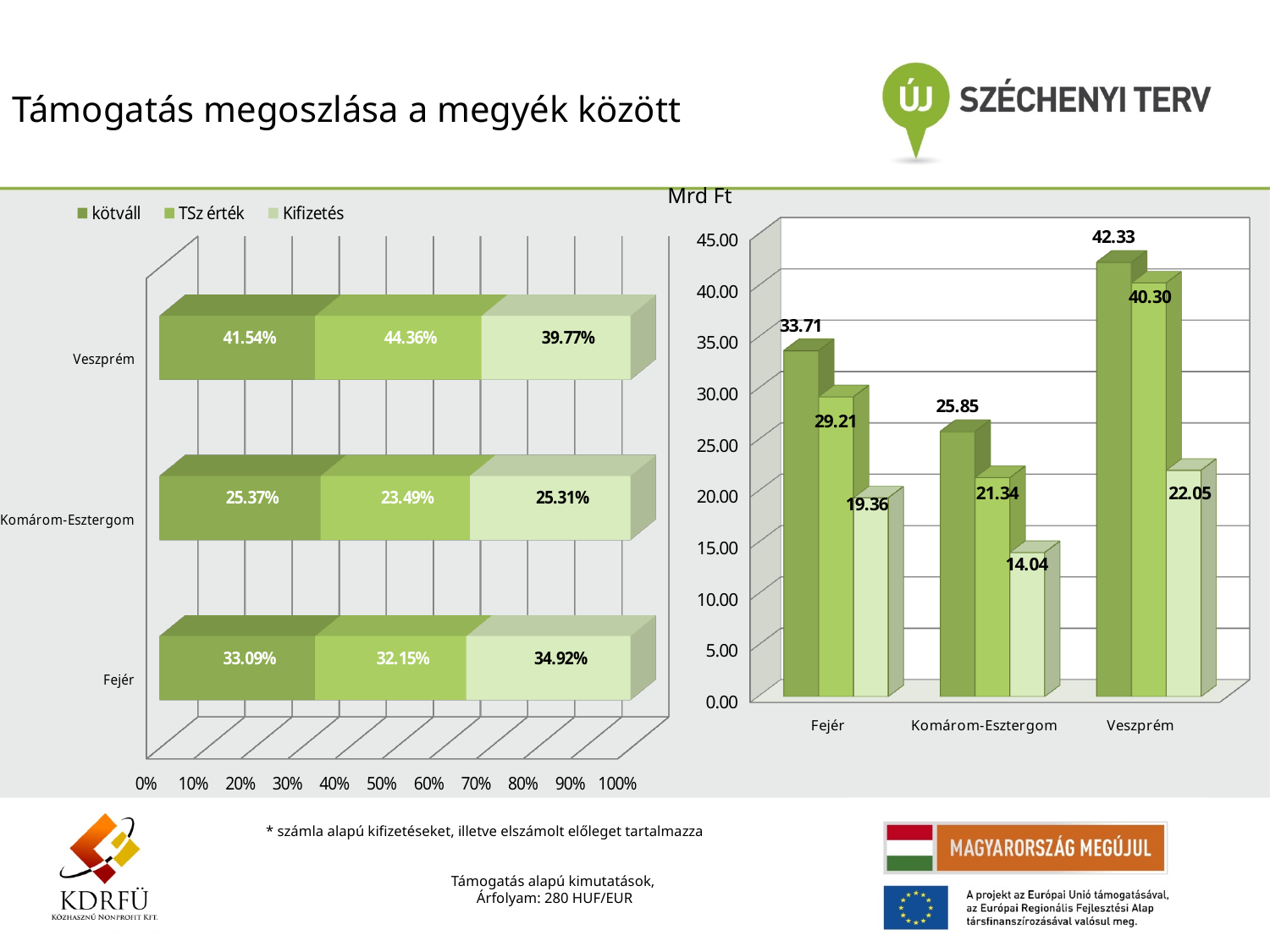
In the left chart, what is the difference between the TSz érték values for Veszprém and Fejér? 12.21% In the left chart, what is the TSz érték value for Komárom-Esztergom? 23.49% In the right chart (Mrd Ft), what is the difference between the tallest bars for Veszprém (42.33) and Fejér (33.71)? 8.62 In the right chart (Mrd Ft), which county has the lowest values across all three bars? Komárom-Esztergom In the left chart, how many series does the legend list? 3 What kind of chart is the right chart (Mrd Ft)? Bar chart In the left chart, which county has the highest kötváll share? Veszprém In the right chart (Mrd Ft), how many counties are shown on the x axis? 3 In the left chart, what is the kötváll value for Veszprém? 41.54% In the right chart (Mrd Ft), what is the lowest value shown for Komárom-Esztergom? 14.04 In the left chart, what is the Kifizetés value for Fejér? 34.92% In the right chart (Mrd Ft), what is the highest value shown for Veszprém? 42.33